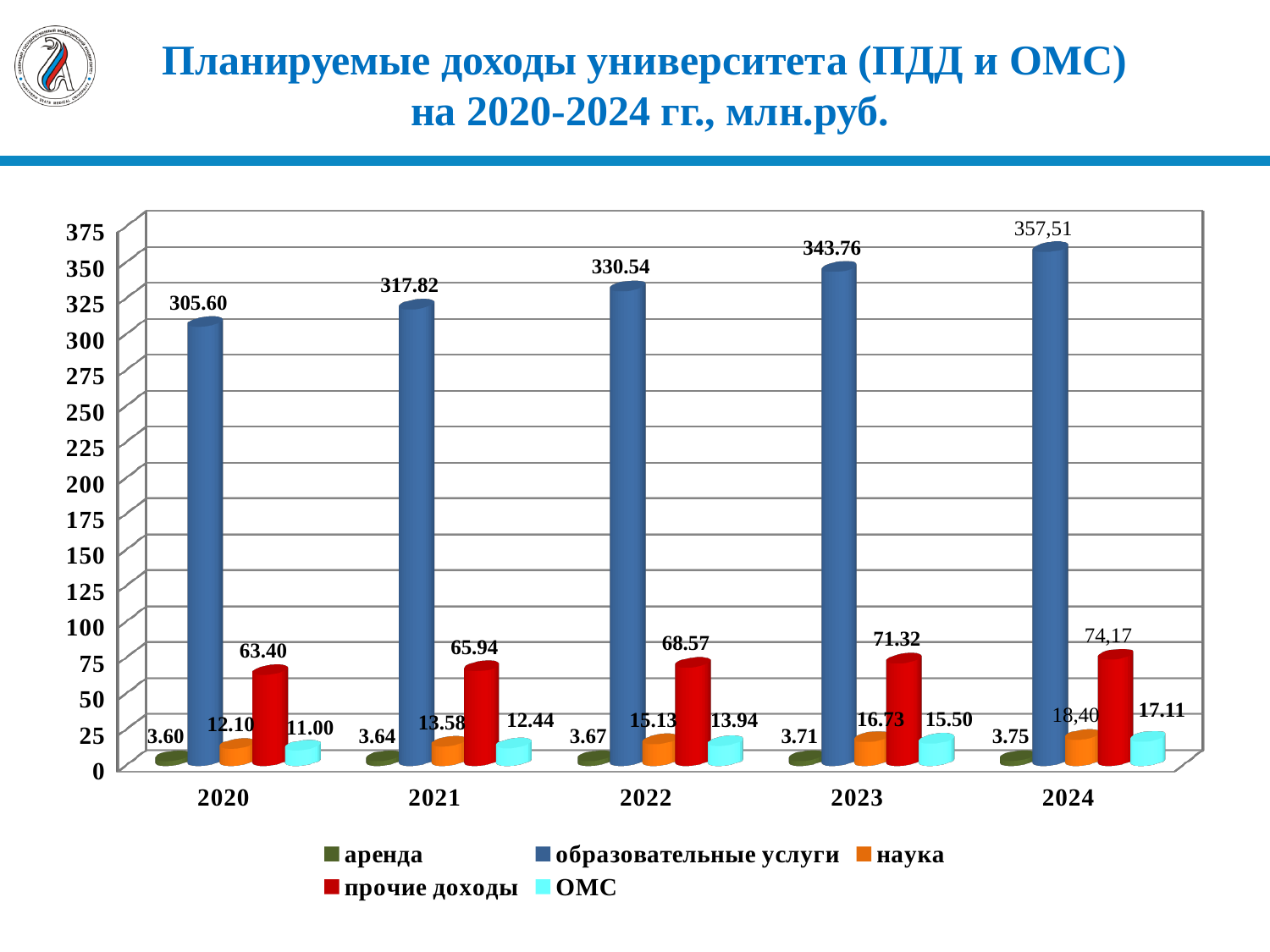
What kind of chart is shown on the slide? bar chart What is the difference between the образовательные услуги values for 2021 and 2020? 12.22 What is the value for наука in 2024? 18,40 What is the value for ОМС in 2023? 15.50 Do the values for прочие доходы rise or fall from 2020 to 2024? rise Which is larger in 2022: the value for наука or the value for ОМС? наука In which year is the value for ОМС the lowest? 2020 In which year is the value for образовательные услуги the highest? 2024 How many series does the legend list? 5 What is the value for прочие доходы in 2020? 63.40 What is the value for образовательные услуги in 2022? 330.54 What is the value for аренда in 2021? 3.64